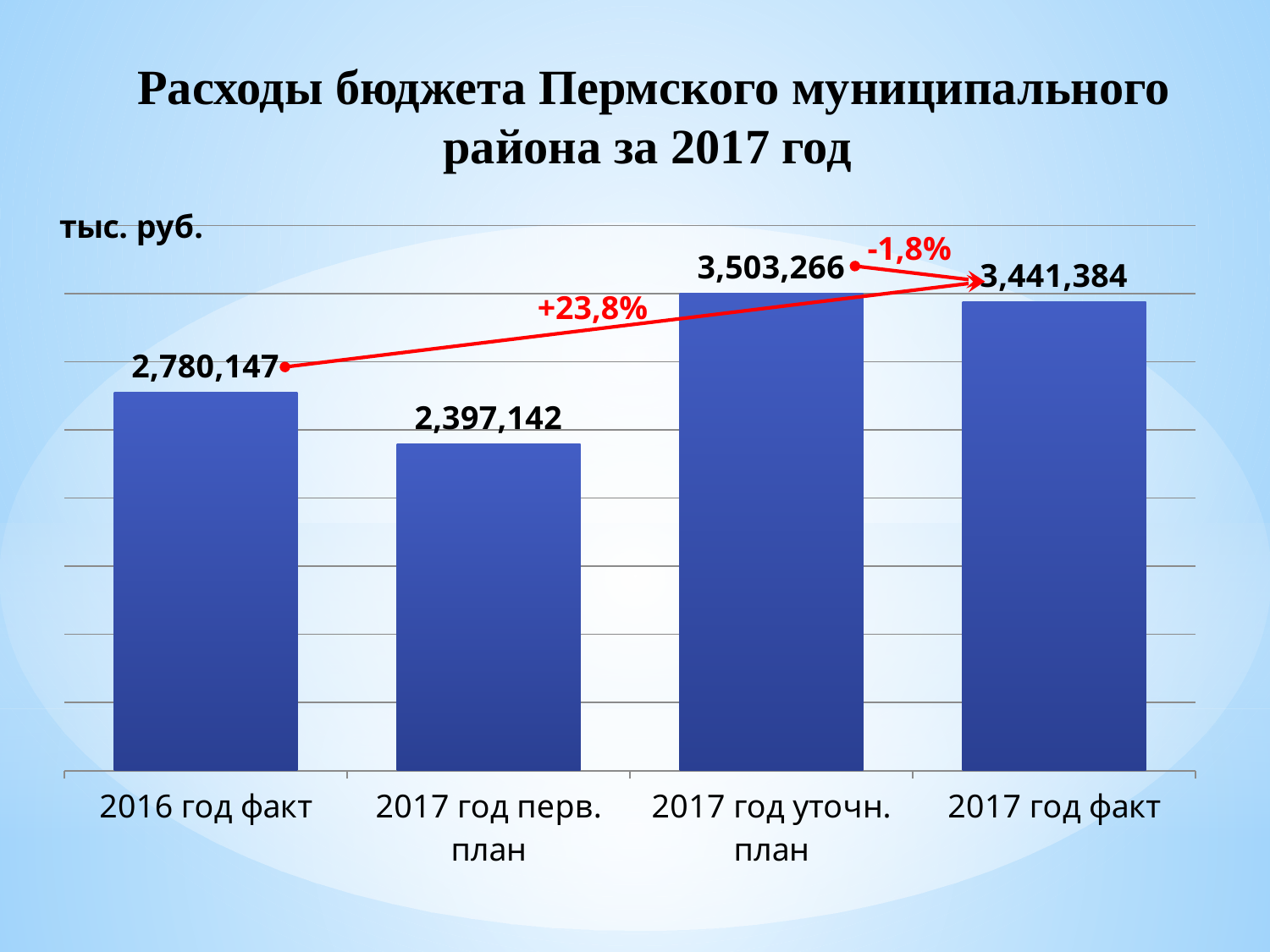
Which category has the lowest value? 2017 год перв. план How many categories are shown on the chart? 4 What is the value for "2017 год перв. план"? 2,397,142 Which category has the highest value? 2017 год уточн. план What is the value for "2016 год факт"? 2,780,147 What is the value for "2017 год уточн. план"? 3,503,266 What is the difference between "2017 год уточн. план" and "2017 год факт"? 61,882 Which is larger, "2016 год факт" or "2017 год факт"? 2017 год факт What is the difference between "2016 год факт" and "2017 год перв. план"? 383,005 What kind of chart is shown on the slide? Bar chart What percentage change is annotated between "2016 год факт" and "2017 год факт"? +23,8% What is the value for "2017 год факт"? 3,441,384